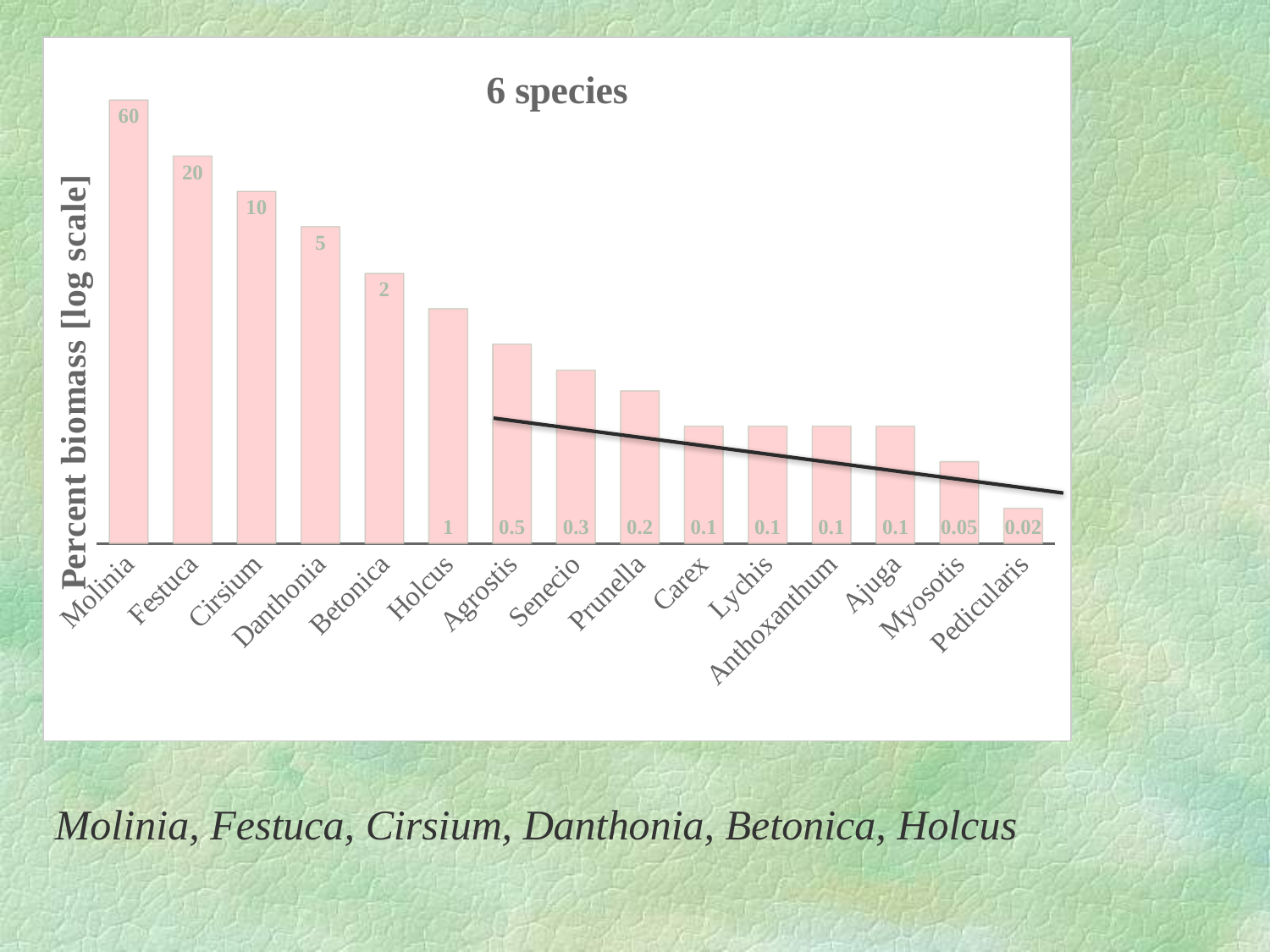
Do the values rise or fall from left to right along the x axis? Fall Which has a larger percent biomass, Betonica or Agrostis? Betonica What is the percent biomass value for Molinia? 60 What is the percent biomass value for Myosotis? 0.05 What is the label of the vertical axis? Percent biomass [log scale] What is the percent biomass value for Danthonia? 5 How many species are shown on the x axis of the chart? 15 What is the percent biomass value for Senecio? 0.3 What kind of chart is shown on the slide? Bar chart Which species has the lowest percent biomass? Pedicularis Which species has the highest percent biomass? Molinia What is the difference between the values for Festuca and Cirsium? 10